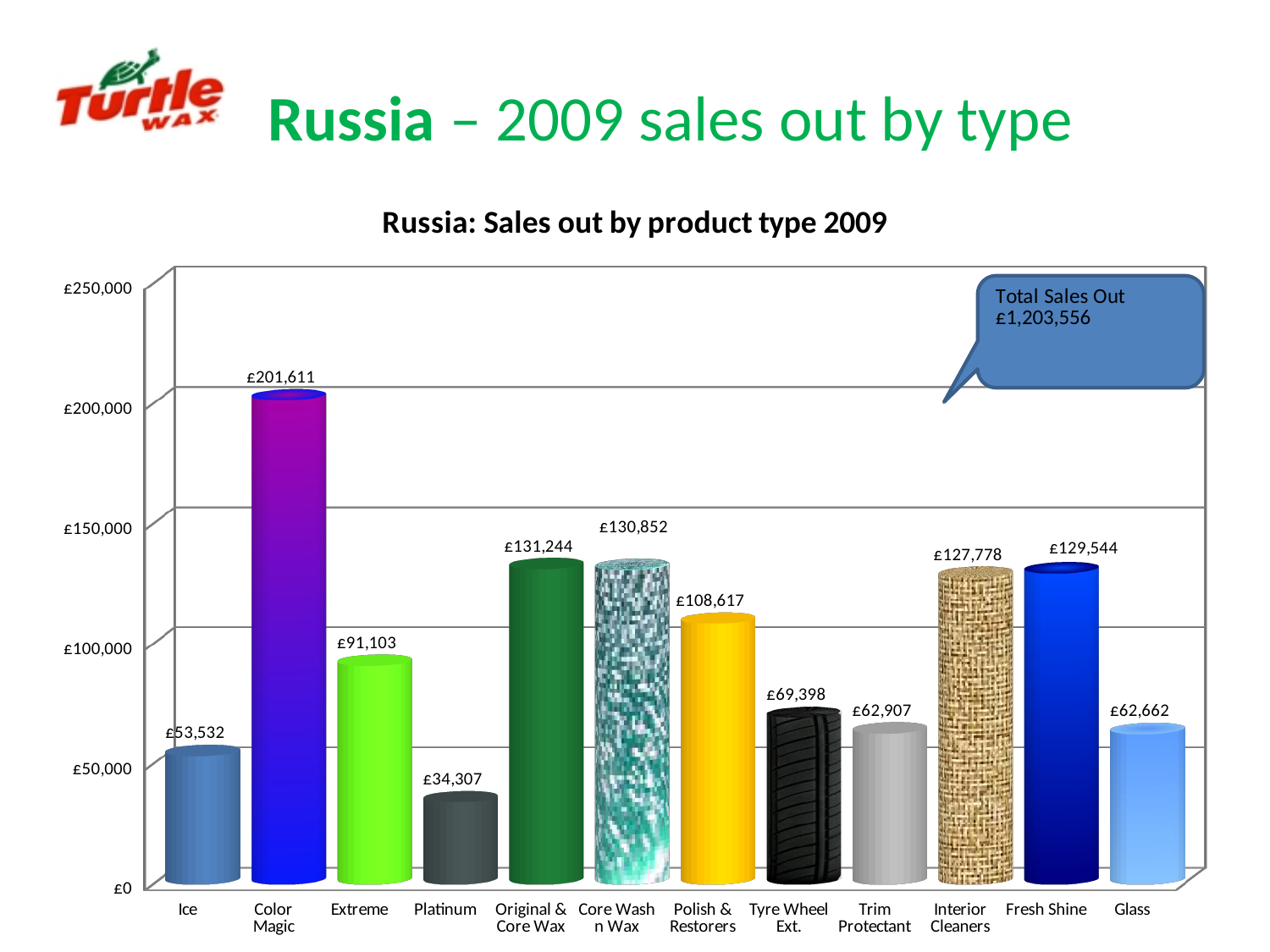
How many product types are shown on the chart? 12 What is the difference in sales out between Ice and Platinum? £19,225 What is the difference in sales out between Color Magic and Extreme? £110,508 What is the sales out value for Platinum? £34,307 Which has higher sales out, Polish & Restorers or Glass? Polish & Restorers What is the sales out value for Tyre Wheel Ext.? £69,398 What is the sales out value for Interior Cleaners? £127,778 Which product type has the lowest sales out? Platinum Is the sales out value for Fresh Shine greater or less than £100,000? greater What is the total sales out figure shown in the callout on the chart? £1,203,556 What is the sales out value for Color Magic? £201,611 Which product type has the highest sales out? Color Magic